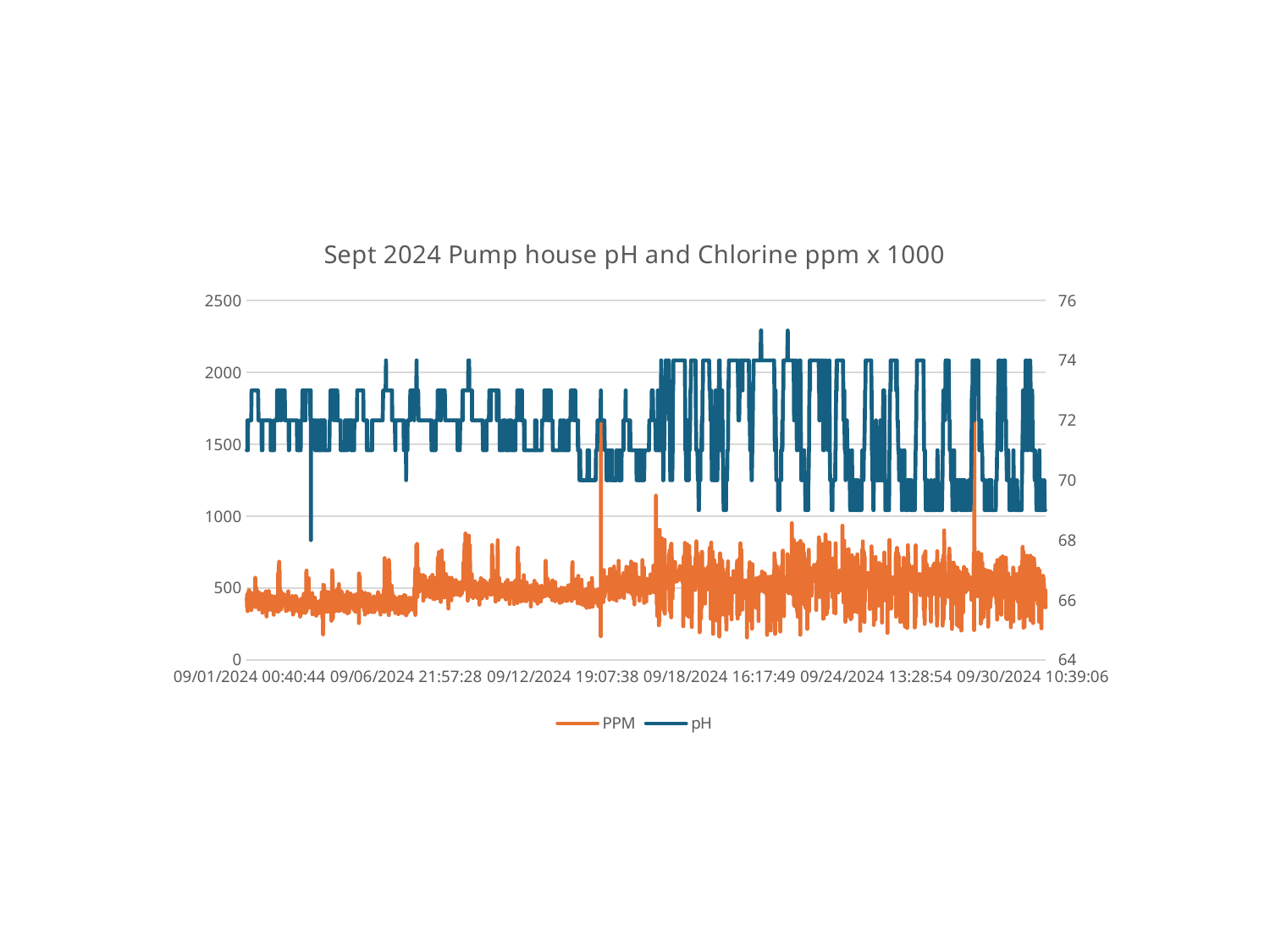
Does the PPM series generally rise or fall from the start of September to the end of September? rise What is the lowest value shown on the right vertical axis? 64 What is the highest value shown on the left vertical axis? 2500 How many date labels are shown along the x axis? 6 What kind of chart is shown on the slide? line chart How many series does the legend list? 2 Which series is drawn in orange? PPM What is the first date label shown on the x axis? 09/01/2024 00:40:44 What is the title of the chart? Sept 2024 Pump house pH and Chlorine ppm x 1000 Is the PPM value at the start of the month (09/01/2024) greater or less than 1000 on the left axis? less Is the PPM value at the start of the month (09/01/2024) greater or less than 0 on the left axis? greater Is the pH series ever plotted above 76 on the right axis? no